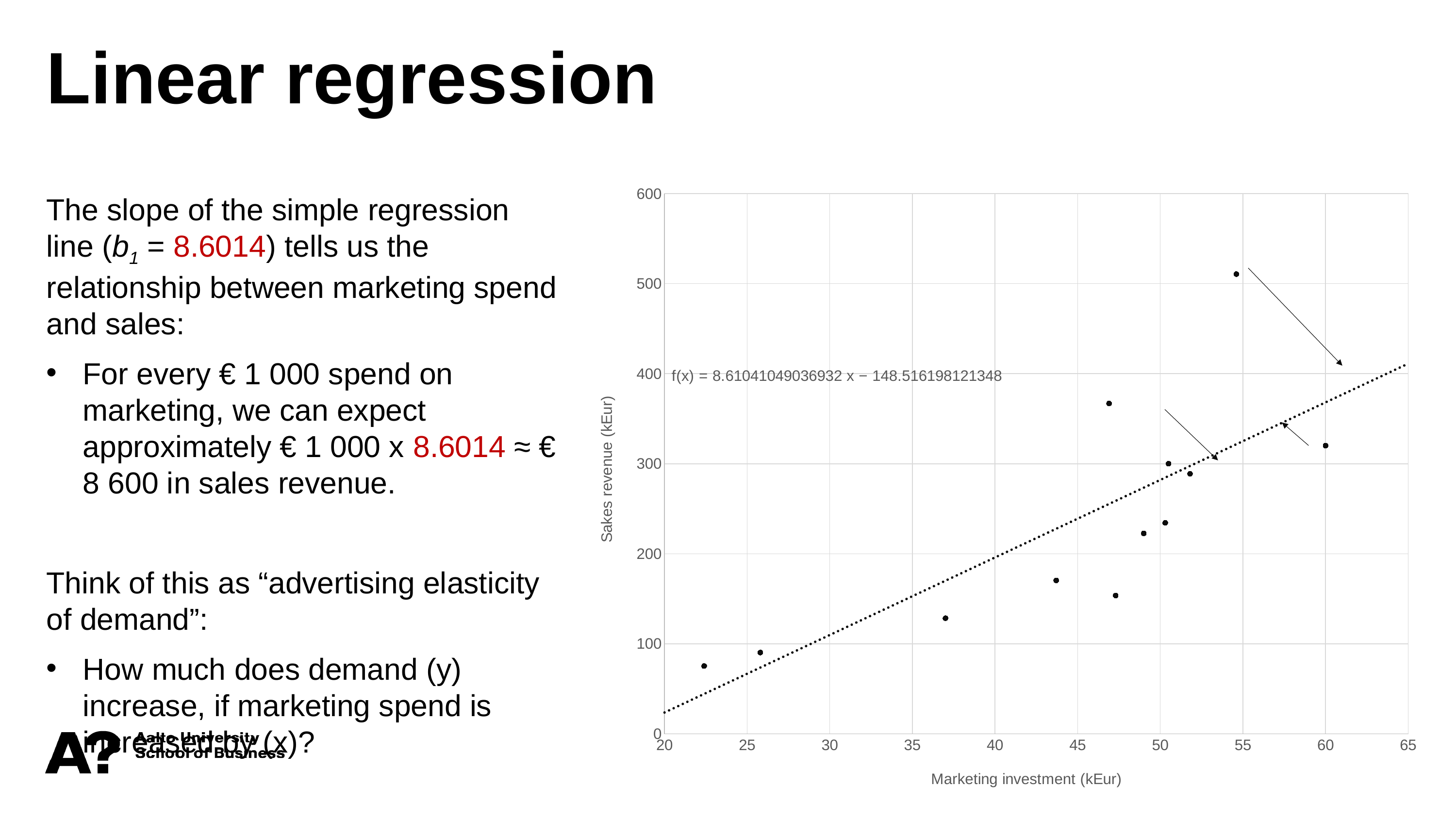
What kind of chart is shown on the slide? scatter chart Is the highest plotted sales revenue value greater or less than 500? greater Is the lowest plotted sales revenue value greater or less than 100? less What is the title of the x axis of the chart? Marketing investment (kEur) What is the maximum value shown on the y axis of the chart? 600 Is the sales revenue for the point at a marketing investment of about 60 kEur greater or less than 300? greater What is the equation of the trendline printed on the chart? f(x) = 8.61041049036932 x − 148.516198121348 Which has the higher sales revenue: the point at about 55 kEur marketing investment or the point at about 60 kEur? the point at about 55 kEur Do the plotted sales revenue values generally rise or fall as marketing investment increases? rise What is the title of the y axis of the chart? Sakes revenue (kEur)